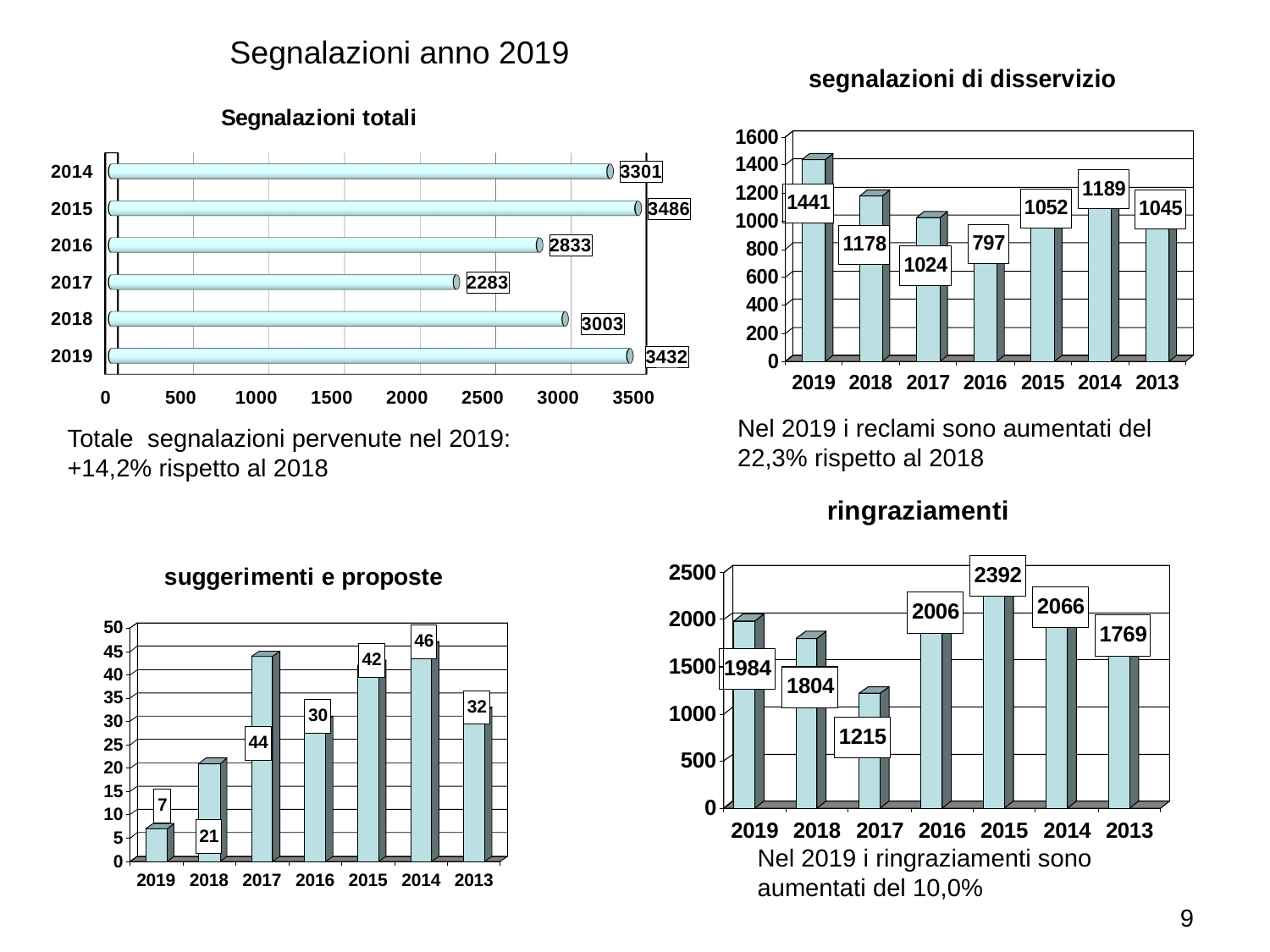
In the 'ringraziamenti' chart, what is the value for 2015? 2392 In the 'Segnalazioni totali' chart, which year has the highest value? 2015 In the 'Segnalazioni totali' chart, which year has the lowest value? 2017 In the 'ringraziamenti' chart, how many years are shown? 7 In the 'Segnalazioni totali' chart, what is the value for 2019? 3432 In the 'Segnalazioni totali' chart, what is the difference between the values for 2015 and 2017? 1203 In the 'suggerimenti e proposte' chart, which is larger, the value for 2017 or the value for 2015? 2017 In the 'suggerimenti e proposte' chart, which year has the lowest value? 2019 In the 'segnalazioni di disservizio' chart, what is the value for 2016? 797 In the 'segnalazioni di disservizio' chart, which year has the highest value? 2019 What kind of chart is the 'Segnalazioni totali' chart? Bar chart In the 'segnalazioni di disservizio' chart, what is the difference between the values for 2019 and 2018? 263